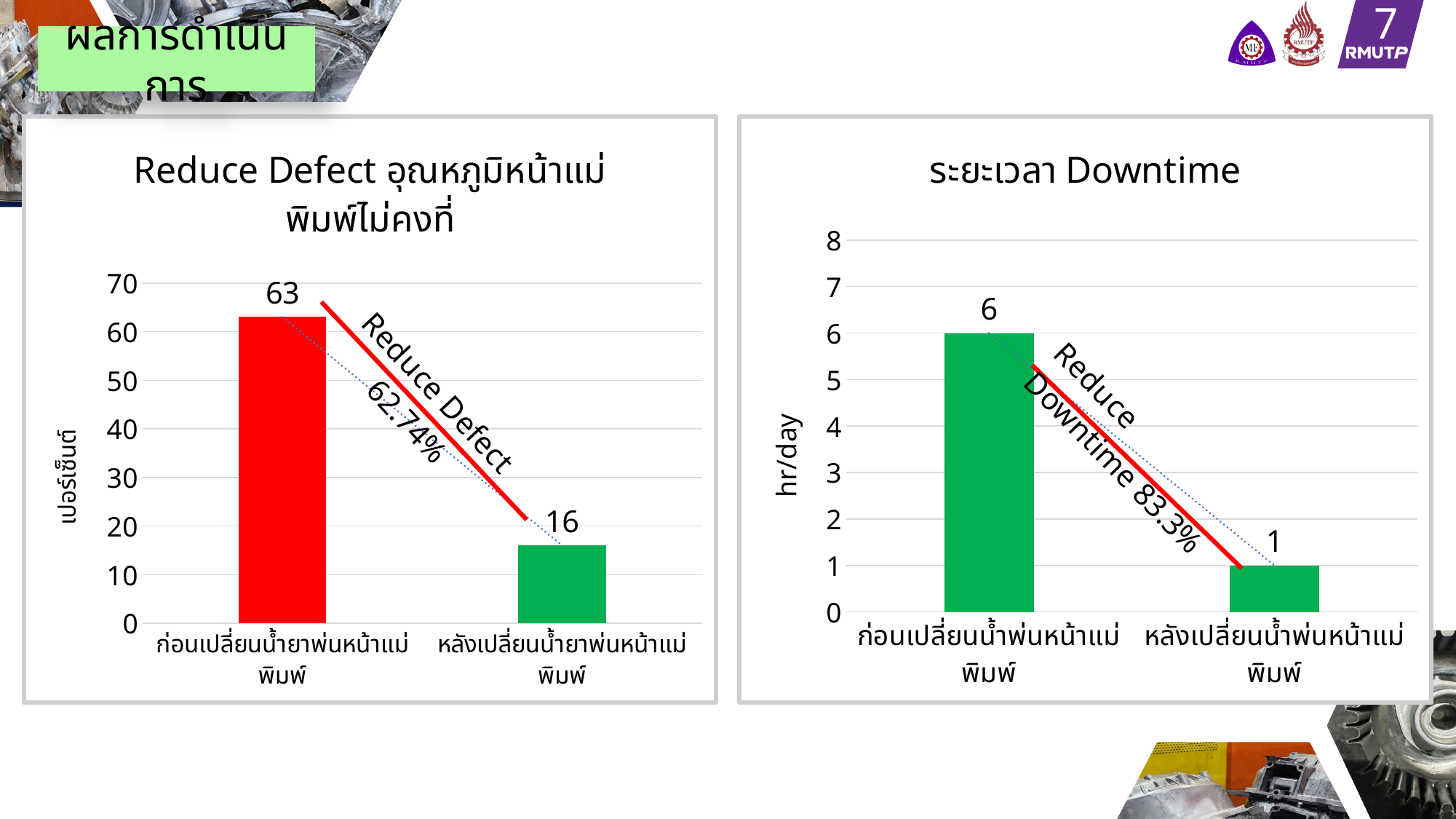
In the right chart (ระยะเวลา Downtime), what is the difference between the before and after values? 5 In the right chart (ระยะเวลา Downtime), what is the value for หลังเปลี่ยนน้ำยาพ่นหน้าแม่พิมพ์? 1 In the right chart (ระยะเวลา Downtime), what is the y-axis unit label? hr/day In the left chart (Reduce Defect), what is the value for ก่อนเปลี่ยนน้ำยาพ่นหน้าแม่พิมพ์? 63 What type of chart is the left chart (Reduce Defect)? bar chart In the left chart (Reduce Defect), what percentage reduction is written on the annotation? 62.74% In the left chart (Reduce Defect), what is the difference between the before and after values? 47 In the right chart (ระยะเวลา Downtime), which category has the lowest value? หลังเปลี่ยนน้ำพ่นหน้าแม่พิมพ์ In the left chart (Reduce Defect), which category has the higher value? ก่อนเปลี่ยนน้ำยาพ่นหน้าแม่พิมพ์ In the right chart (ระยะเวลา Downtime), what is the value for ก่อนเปลี่ยนน้ำยาพ่นหน้าแม่พิมพ์? 6 How many categories are shown in the right chart (ระยะเวลา Downtime)? 2 In the left chart (Reduce Defect), what is the value for หลังเปลี่ยนน้ำยาพ่นหน้าแม่พิมพ์? 16